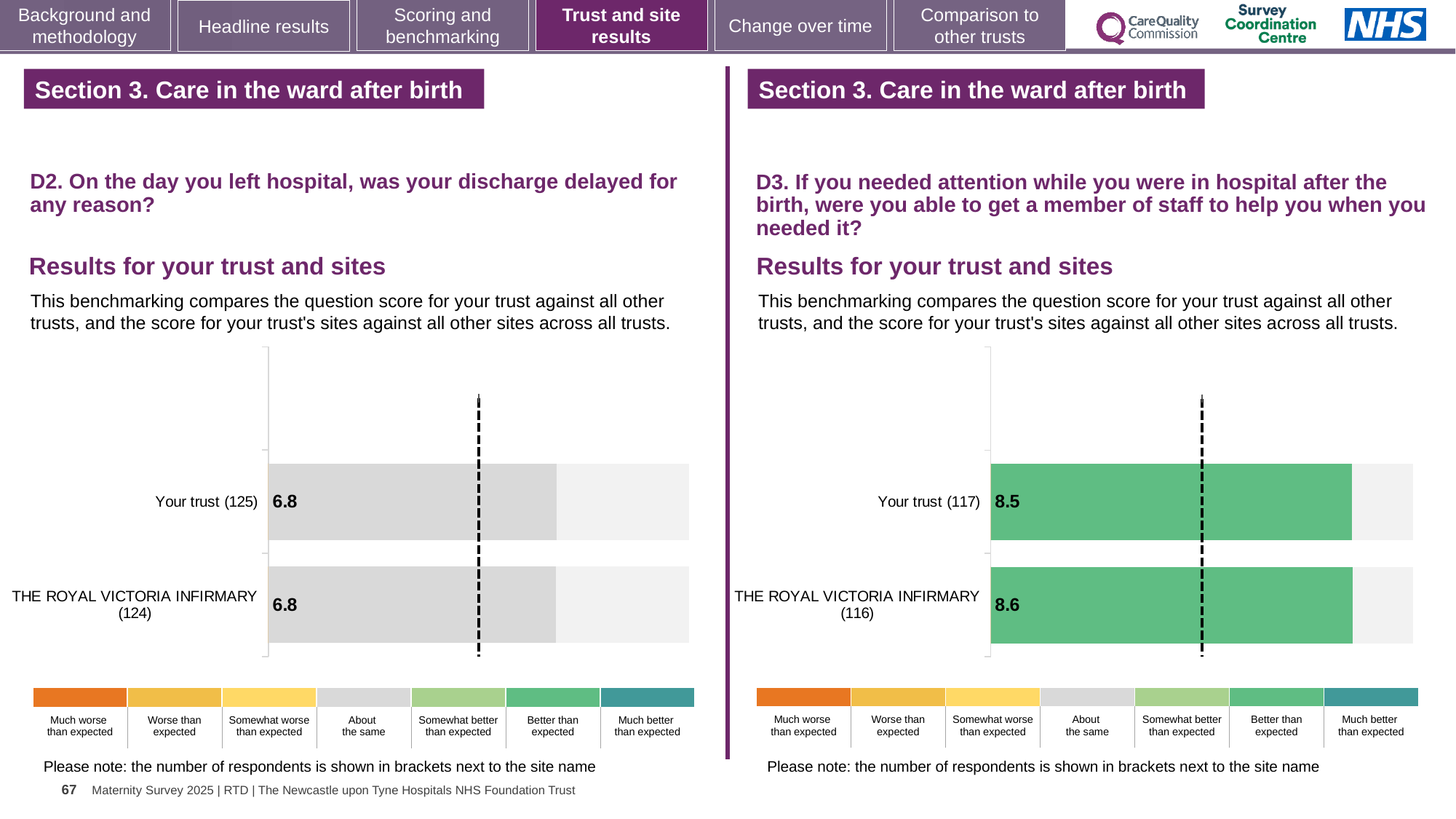
What kind of chart is used in the D3 chart (right)? Bar chart In the D3 chart (right), what is the score for Your trust? 8.5 In the D2 chart (left), what is the score for Your trust? 6.8 In the D2 chart (left), which benchmark category does the colour of the Your trust bar correspond to? About the same In the D3 chart (right), which has the higher score, Your trust or THE ROYAL VICTORIA INFIRMARY? THE ROYAL VICTORIA INFIRMARY How many bars are plotted in the D2 chart (left)? 2 In the D3 chart (right), which benchmark category does the colour of the Your trust bar correspond to? Better than expected In the D3 chart (right), what is the score for THE ROYAL VICTORIA INFIRMARY? 8.6 In the D2 chart (left), what is the difference between the score for Your trust and the score for THE ROYAL VICTORIA INFIRMARY? 0 In the D2 chart (left), how many respondents are shown in brackets for THE ROYAL VICTORIA INFIRMARY? 124 In the D3 chart (right), what is the difference between the score for THE ROYAL VICTORIA INFIRMARY and the score for Your trust? 0.1 In the D2 chart (left), what is the score for THE ROYAL VICTORIA INFIRMARY? 6.8